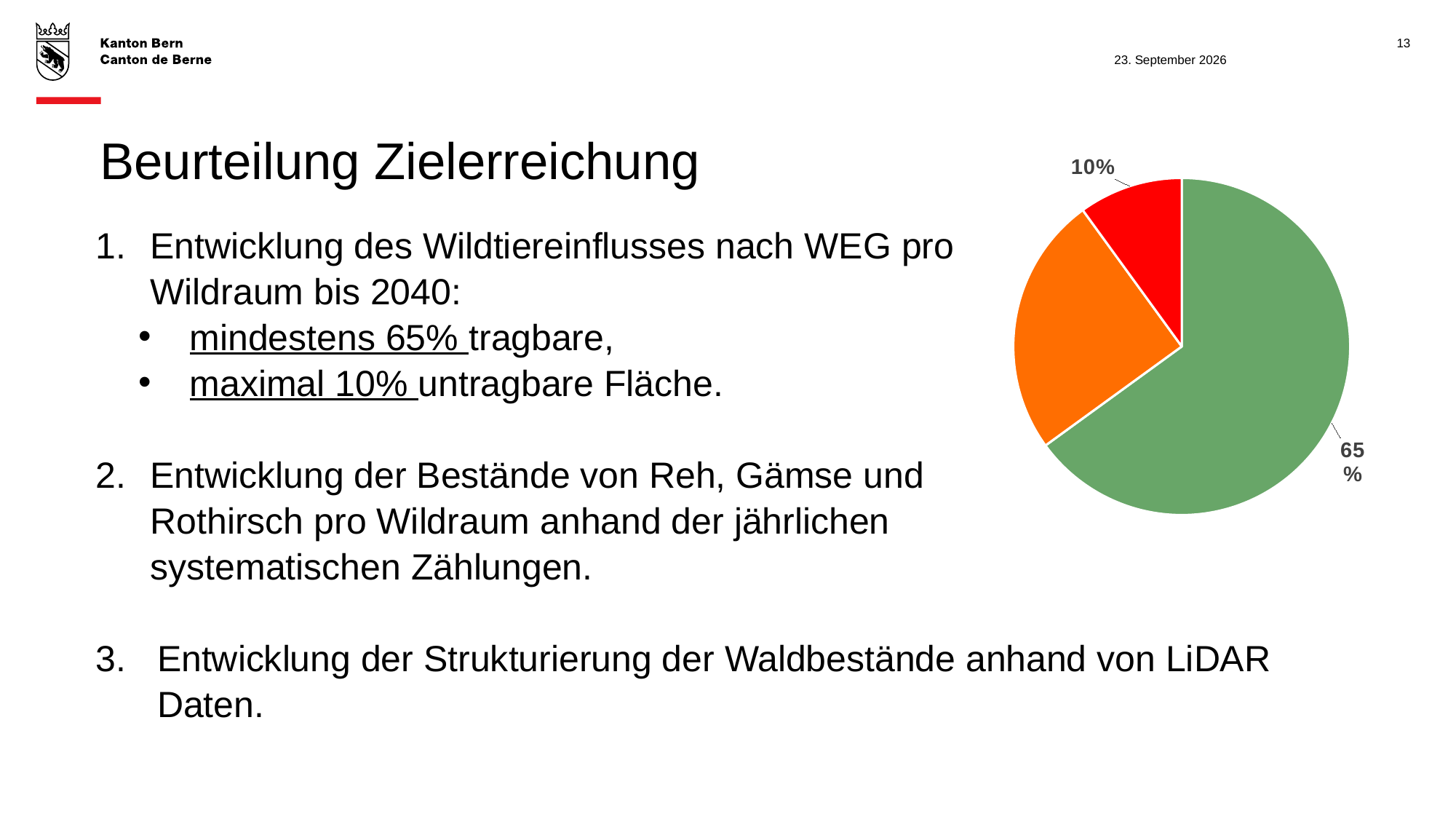
What is the difference between the green slice's value and the red slice's value in the pie chart? 55% What percentage is shown on the green slice of the pie chart? 65% Which slice of the pie chart is the smallest? the red slice (10%) What percentage is shown on the red slice of the pie chart? 10% How many slices does the pie chart have? 3 Which slice of the pie chart has no data label? the orange slice Which is larger in the pie chart, the green slice or the red slice? the green slice What colours are the three slices of the pie chart? green, orange and red Which slice of the pie chart is the largest? the green slice (65%) What kind of chart is shown on the right side of the slide? pie chart